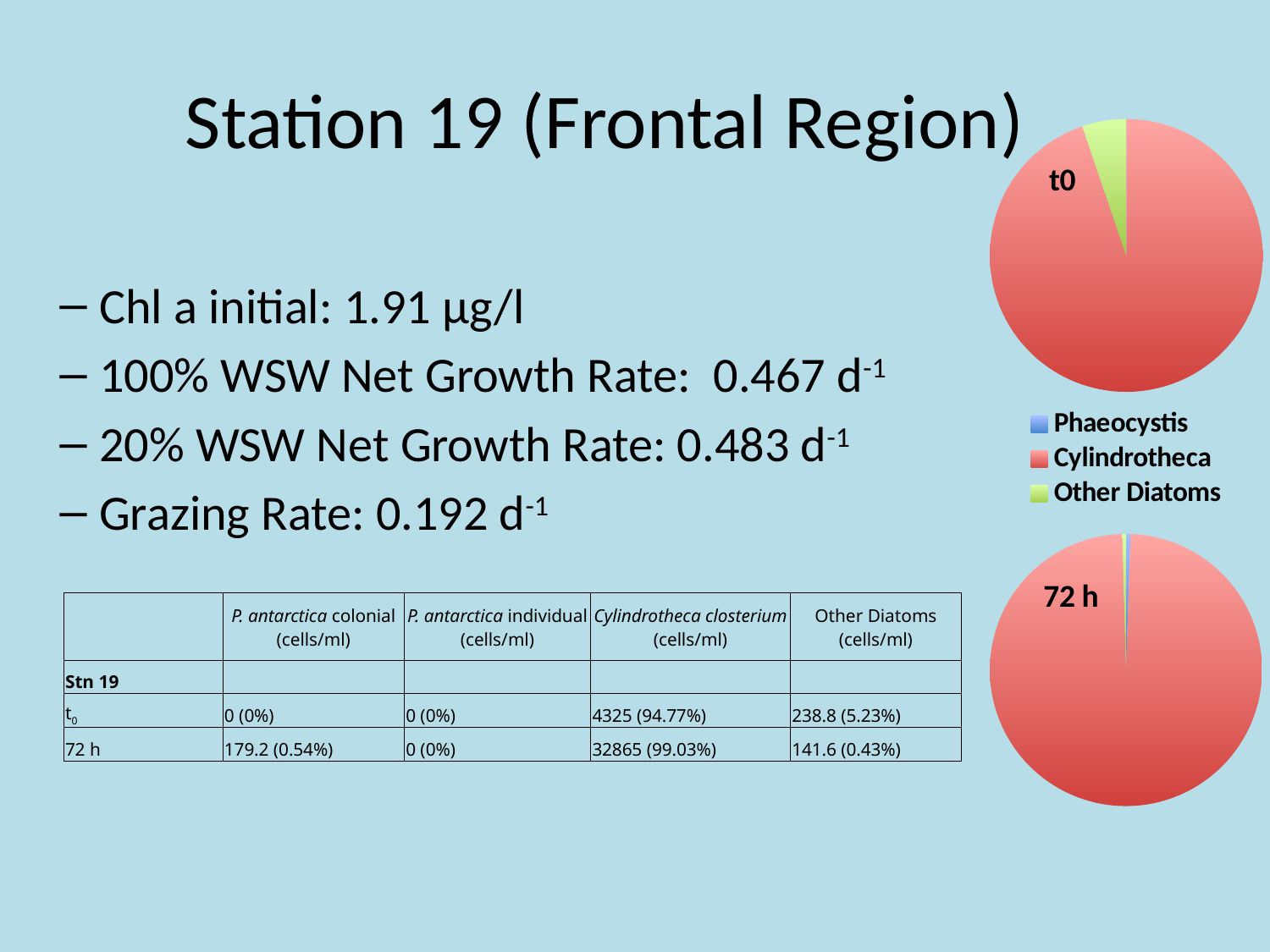
What label is shown on the upper pie chart? t0 How many entries does the legend shared by the pie charts list? 3 How many pie charts are shown on the slide? 2 What kind of chart is the 72 h chart at the bottom right of the slide? pie chart In the t0 pie chart, which is larger, the Cylindrotheca slice or the Other Diatoms slice? Cylindrotheca In the 72 h pie chart, which category has the largest slice? Cylindrotheca What kind of chart is the t0 chart on the right of the slide? pie chart In the t0 pie chart, which category has the largest slice? Cylindrotheca Which legend entry is shown in green? Other Diatoms Which legend entry is shown in blue? Phaeocystis In the 72 h pie chart, which is larger, the Cylindrotheca slice or the Phaeocystis slice? Cylindrotheca